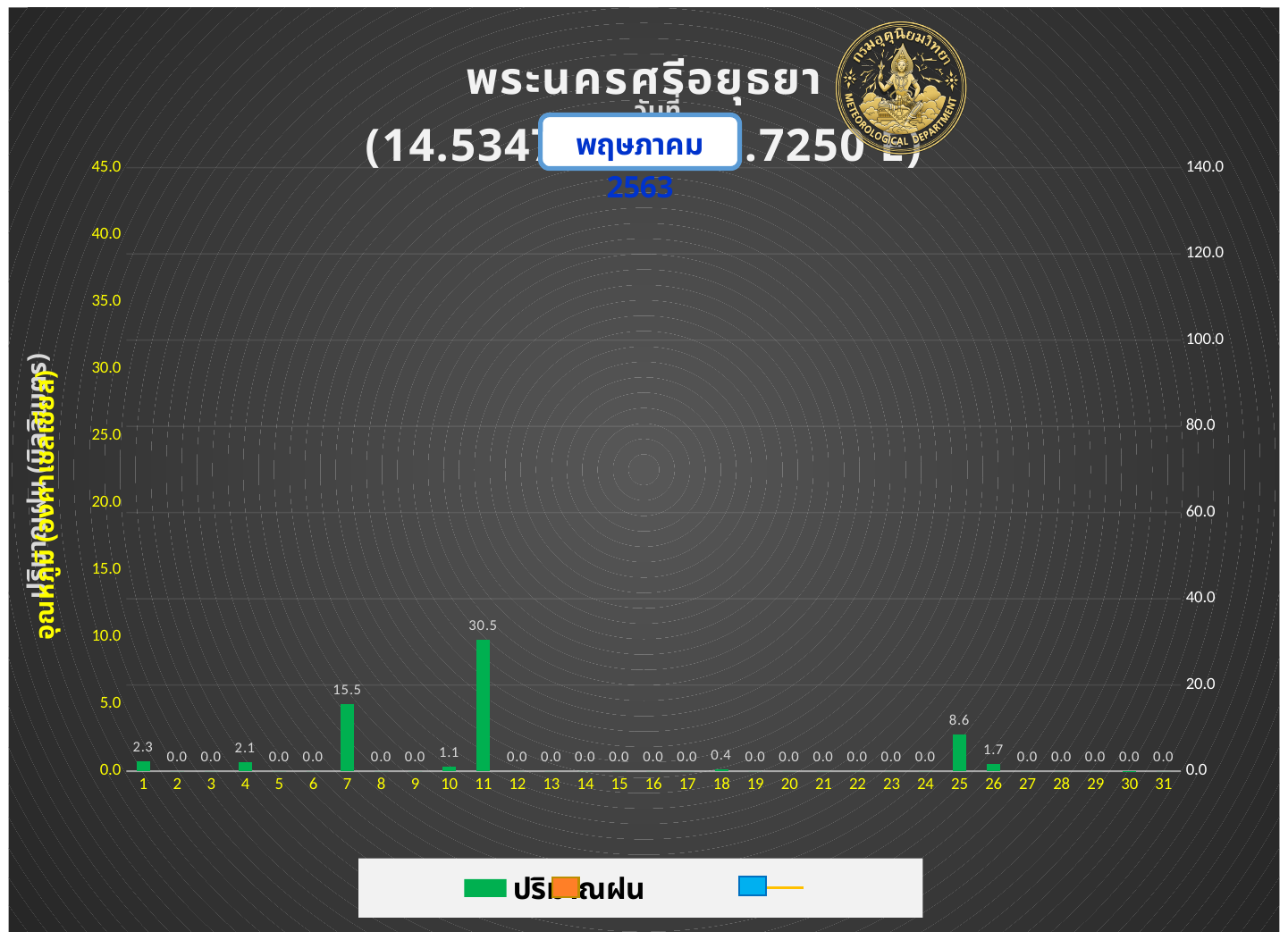
What is the difference between the rainfall values for day 11 and day 7? 15.0 What is the rainfall value shown for day 7? 15.5 What colour are the rainfall bars in the chart? green What is the rainfall value shown for day 11? 30.5 Which day has the highest rainfall value? 11 What is the rainfall value shown for day 25? 8.6 Which is larger, the rainfall value for day 4 or for day 10? day 4 How many days (categories) are shown on the x axis? 31 What is the difference between the rainfall values for day 25 and day 26? 6.9 What is the rainfall value shown for day 1? 2.3 What is the rainfall value shown for day 18? 0.4 What kind of chart is shown on the slide? bar chart